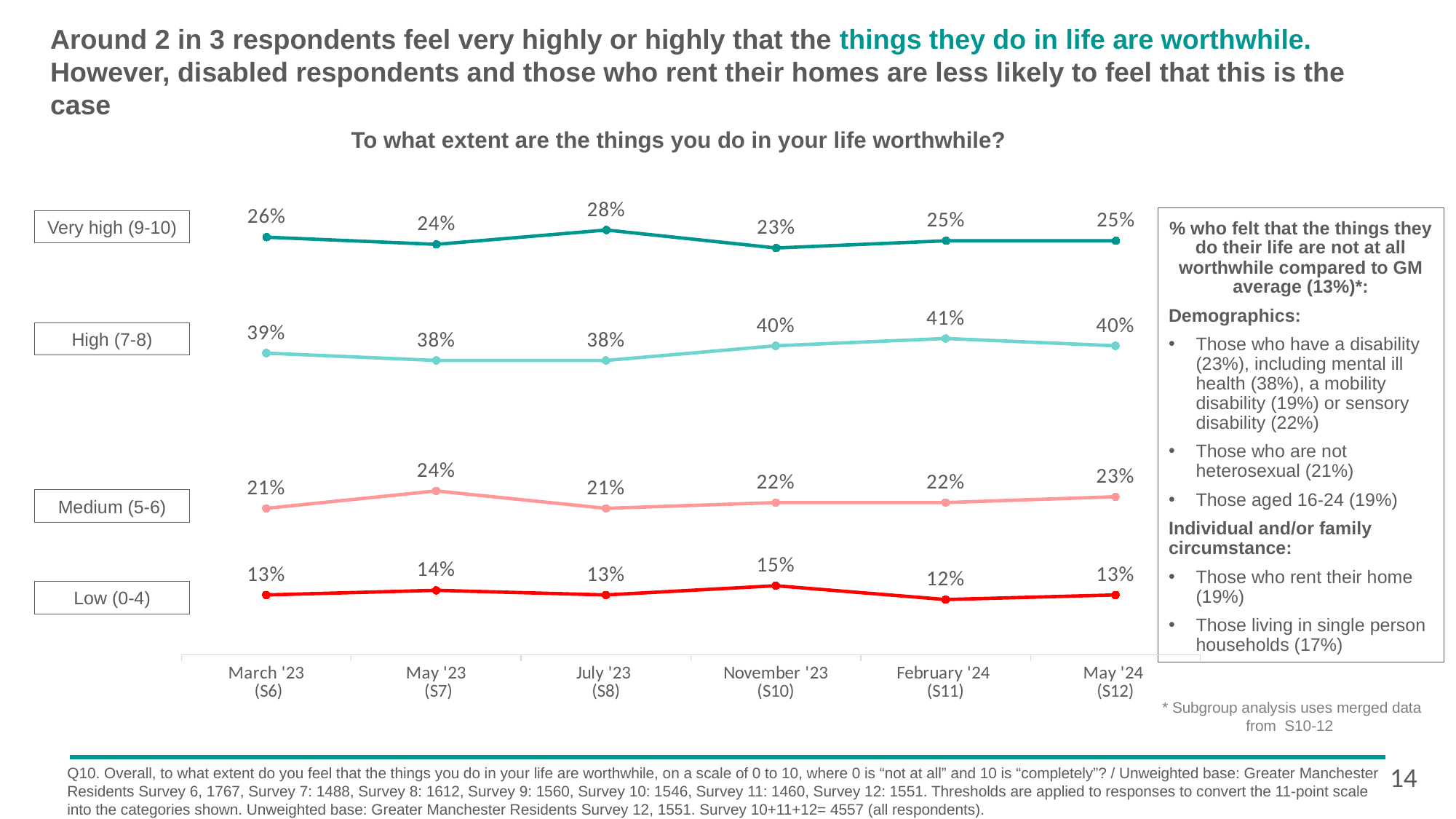
What is the value for High (7-8) in February '24 (S11)? 41% Which is larger in March '23 (S6): the Medium (5-6) value or the Very high (9-10) value? Very high (9-10) In which survey wave is the Low (0-4) value highest? November '23 (S10) What is the difference between the High (7-8) and Very high (9-10) values in May '24 (S12)? 15 percentage points How many survey waves are shown on the x axis? 6 How many series (response categories) are plotted on the chart? 4 What is the title of the chart? To what extent are the things you do in your life worthwhile? What is the value for Medium (5-6) in May '23 (S7)? 24% In which survey wave is the Very high (9-10) value lowest? November '23 (S10) What is the value for Low (0-4) in November '23 (S10)? 15% What type of chart is shown on the slide? Line chart What is the value for Very high (9-10) in July '23 (S8)? 28%